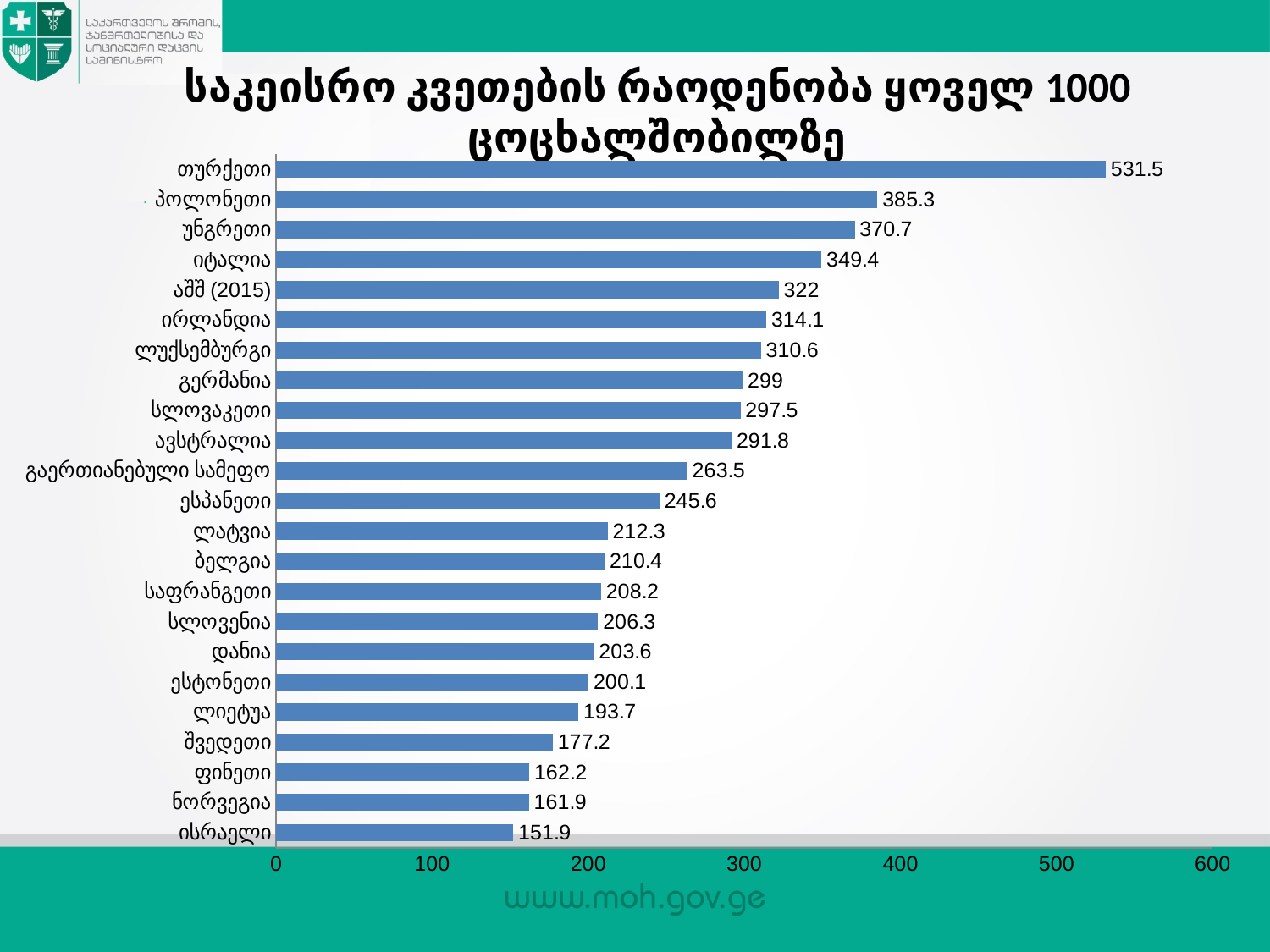
What is the title of the chart? საკეისრო კვეთების რაოდენობა ყოველ 1000 ცოცხალშობილზე Which category has the lowest value? ისრაელი What is the difference between the values for თურქეთი and პოლონეთი? 146.2 What is the difference between the values for ფინეთი and ნორვეგია? 0.3 Is the value for ესპანეთი greater or less than 300? less Which has a larger value, იტალია or უნგრეთი? უნგრეთი What is the value for აშშ (2015)? 322 Which category has the highest value? თურქეთი What is the value for გერმანია? 299 What is the value for თურქეთი? 531.5 What kind of chart is shown on the slide? bar chart How many categories are shown in the chart? 23